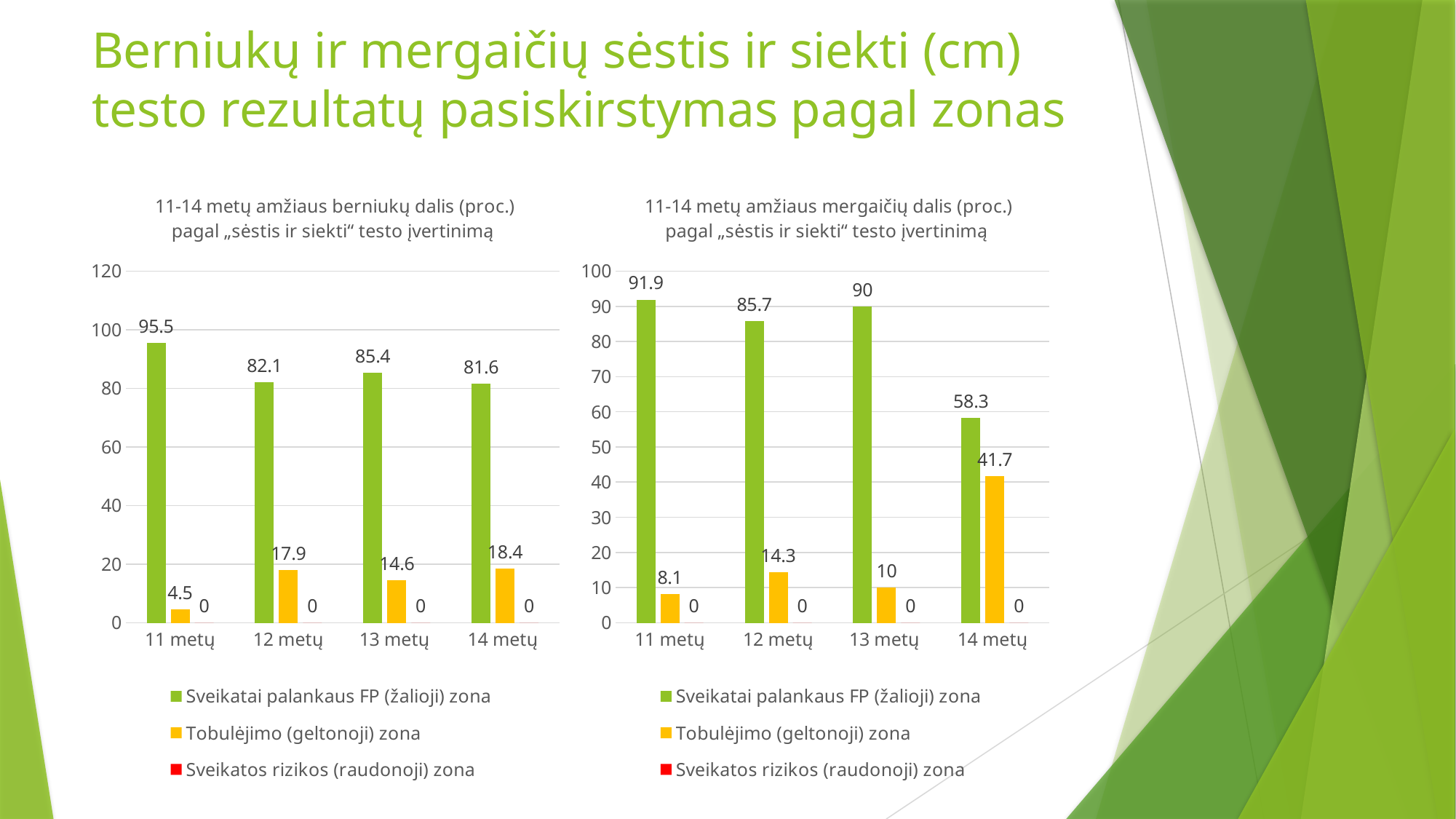
In the left chart (boys), what is the value of the green zone (Sveikatai palankaus FP) for 11 metų? 95.5 What kind of chart is the left chart (boys)? bar chart In the left chart (boys), which age group has the highest green zone value? 11 metų In the left chart (boys), what is the difference between the yellow zone values for 14 metų and 11 metų? 13.9 In the right chart (girls), what is the value of the yellow zone (Tobulėjimo) for 14 metų? 41.7 What colour represents the Tobulėjimo zona series in both charts? yellow In the left chart (boys), what is the difference between the green zone values for 11 metų and 14 metų? 13.9 How many series does the legend of the right chart (girls) list? 3 In the right chart (girls), which age group has the lowest green zone value? 14 metų In the right chart (girls), what is the value of the red zone (Sveikatos rizikos) for 13 metų? 0 How many age groups are shown on the x axis of the left chart (boys)? 4 In the right chart (girls), which is larger: the yellow zone value for 12 metų or for 13 metų? 12 metų